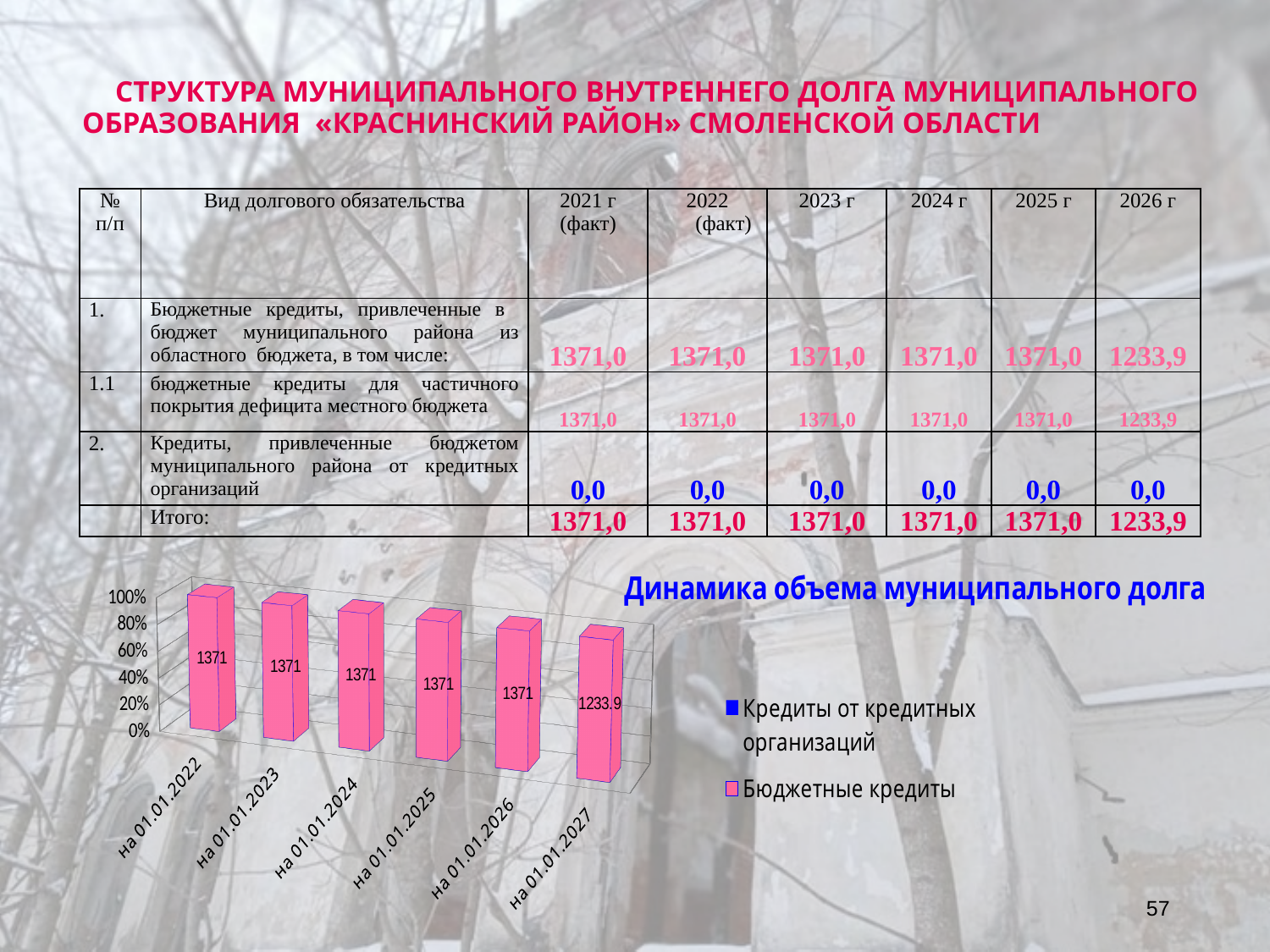
Which category has the lowest labelled value in the chart? на 01.01.2027 What is the title of the chart on the slide? Динамика объема муниципального долга What type of chart is shown under the title 'Динамика объема муниципального долга'? bar chart What is the data label on the bar for на 01.01.2027 in the chart? 1233.9 How many series does the chart legend list? 2 Which legend entry in the chart is shown in pink? Бюджетные кредиты What is the data label on the bar for на 01.01.2022 in the chart? 1371 How many categories are shown on the x axis of the chart? 6 Does the labelled value rise or fall from на 01.01.2026 to на 01.01.2027 in the chart? fall Which is larger in the chart: the value for на 01.01.2026 or the value for на 01.01.2027? на 01.01.2026 What is the difference between the labelled values for на 01.01.2022 and на 01.01.2027 in the chart? 137.1 What is the data label on the bar for на 01.01.2025 in the chart? 1371